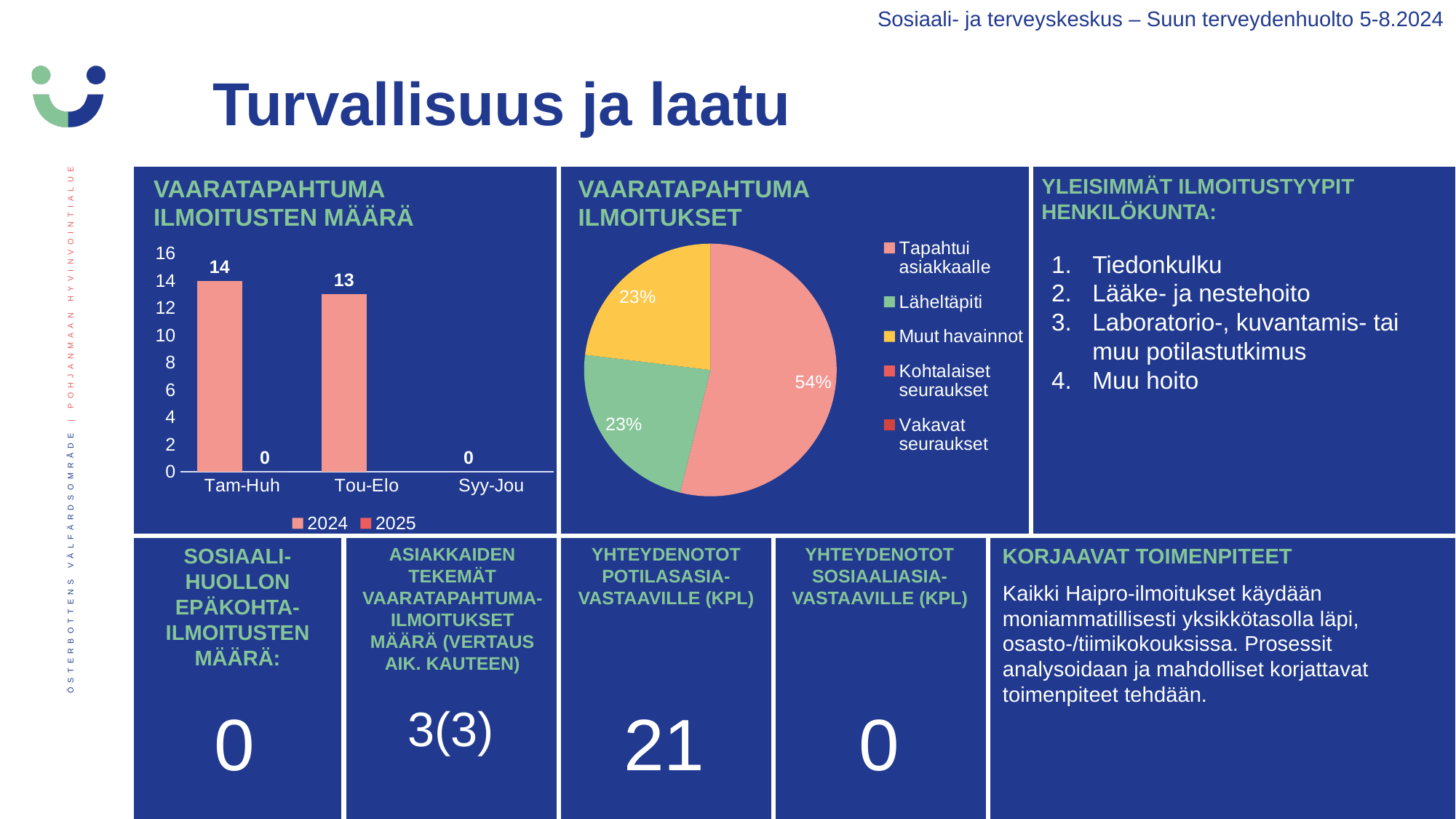
What kind of chart is the one titled VAARATAPAHTUMA ILMOITUSTEN MÄÄRÄ? bar chart In the chart titled VAARATAPAHTUMA ILMOITUSTEN MÄÄRÄ, what is the difference between the 2024 values for Tam-Huh and Tou-Elo? 1 In the pie chart titled VAARATAPAHTUMA ILMOITUKSET, which slice is the largest? Tapahtui asiakkaalle In the chart titled VAARATAPAHTUMA ILMOITUSTEN MÄÄRÄ, which category has the highest 2024 value? Tam-Huh In the pie chart titled VAARATAPAHTUMA ILMOITUKSET, what share does Läheltäpiti have? 23% In the chart titled VAARATAPAHTUMA ILMOITUSTEN MÄÄRÄ, what is the 2025 value for Tam-Huh? 0 In the pie chart titled VAARATAPAHTUMA ILMOITUKSET, what share does Tapahtui asiakkaalle have? 54% In the chart titled VAARATAPAHTUMA ILMOITUSTEN MÄÄRÄ, what is the 2024 value for Tam-Huh? 14 In the pie chart titled VAARATAPAHTUMA ILMOITUKSET, how many entries does the legend list? 5 In the chart titled VAARATAPAHTUMA ILMOITUSTEN MÄÄRÄ, how many series does the legend list? 2 In the chart titled VAARATAPAHTUMA ILMOITUSTEN MÄÄRÄ, what is the 2024 value for Tou-Elo? 13 In the chart titled VAARATAPAHTUMA ILMOITUSTEN MÄÄRÄ, how many categories are shown on the x axis? 3